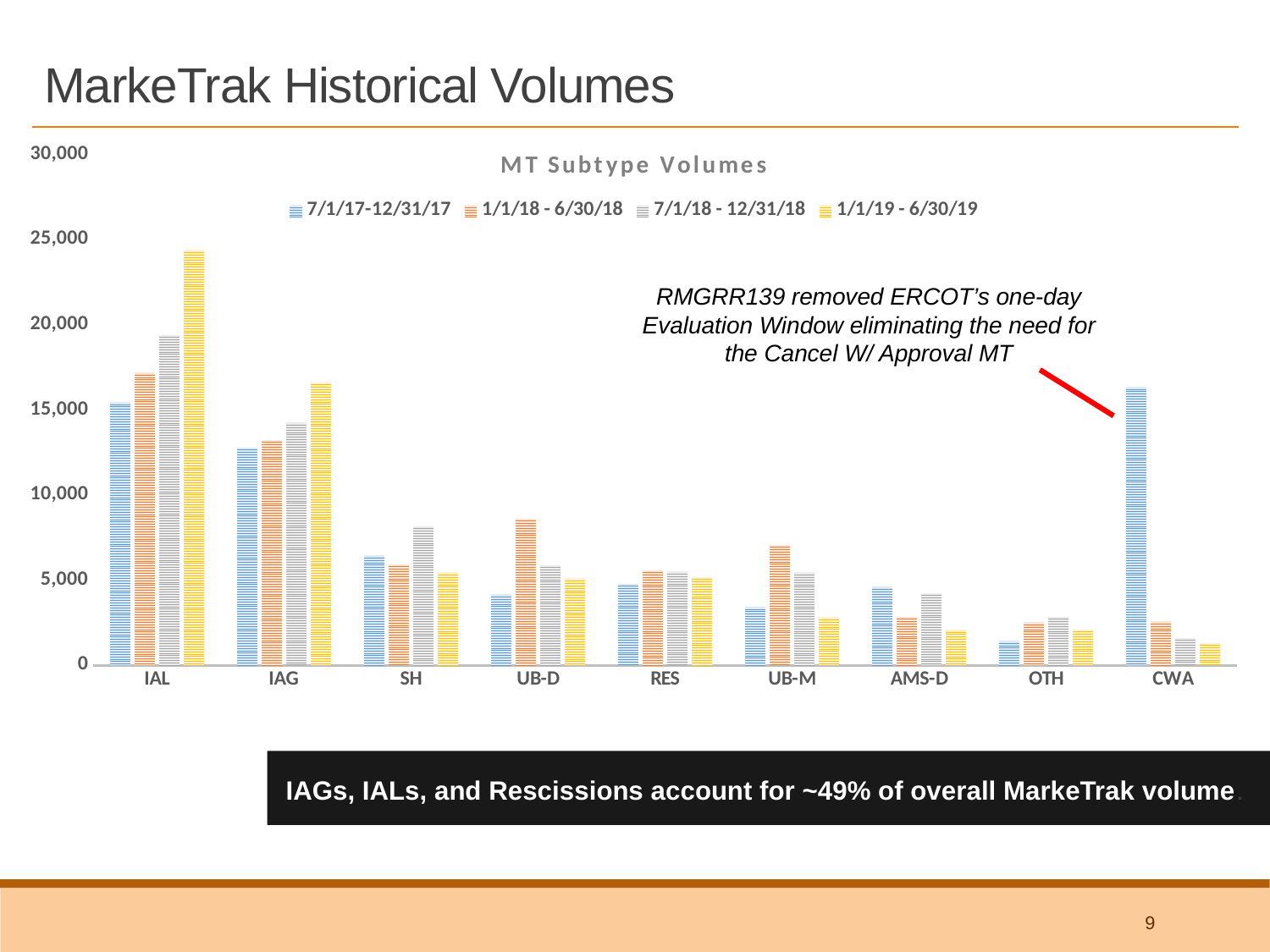
How many subtype categories are shown on the x axis of the chart? 9 Is the 1/1/19 - 6/30/19 value for CWA greater or less than 5,000? less For the 7/1/18 - 12/31/18 series, which is larger: IAL or IAG? IAL What is the title of the chart? MT Subtype Volumes Is the 1/1/19 - 6/30/19 value for IAL greater or less than 20,000? greater How many series does the legend of the MT Subtype Volumes chart list? 4 Is the 7/1/17-12/31/17 value for CWA greater or less than 15,000? greater Do the IAL values rise or fall across the four periods from 7/1/17-12/31/17 to 1/1/19 - 6/30/19? rise Which category has the lowest value for the 7/1/17-12/31/17 series? OTH Which category has the highest value for the 1/1/19 - 6/30/19 series? IAL For UB-D, which series is larger: 7/1/17-12/31/17 or 1/1/18 - 6/30/18? 1/1/18 - 6/30/18 What kind of chart is shown on the slide? bar chart